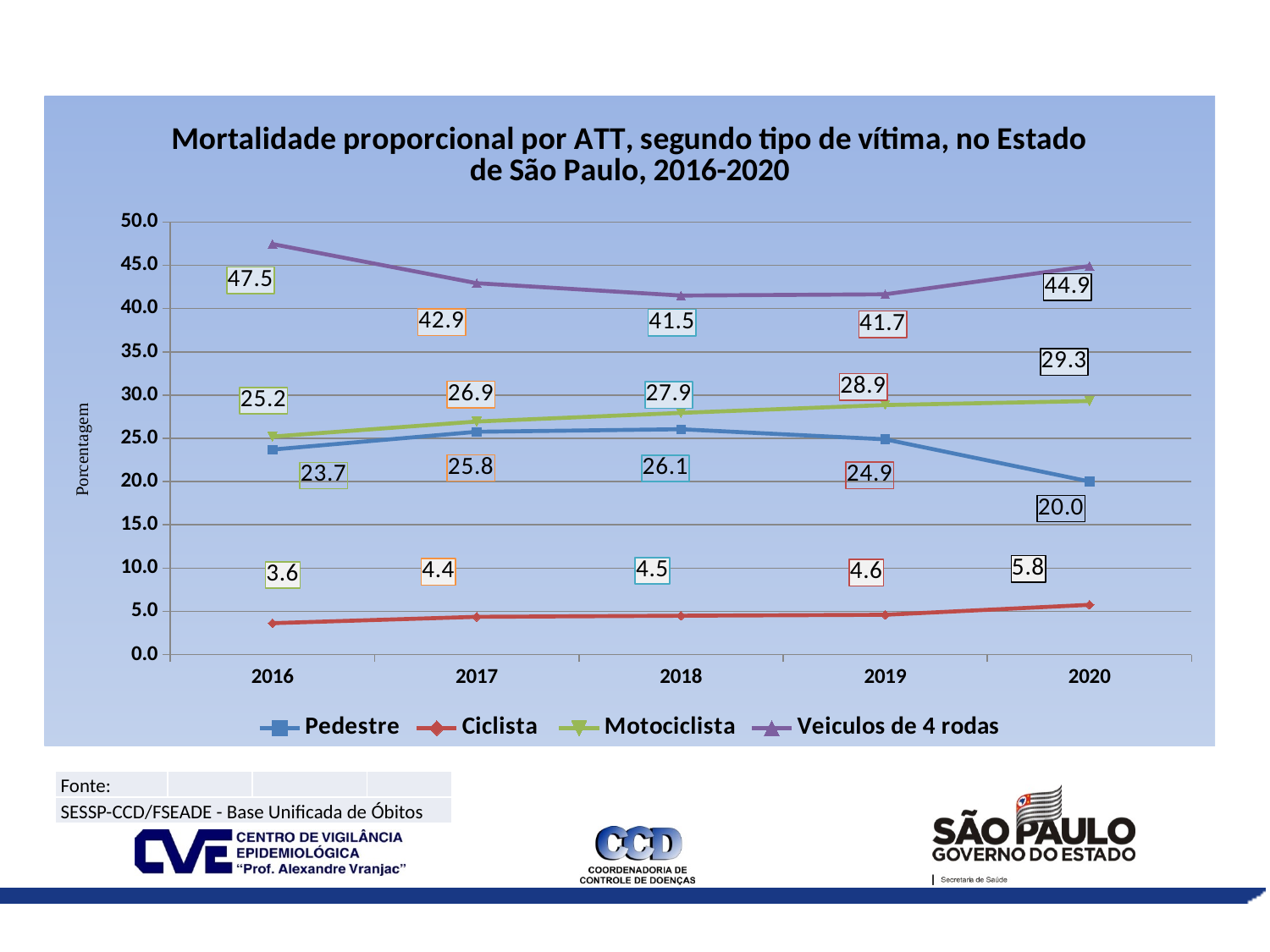
What is the value for Ciclista in 2019? 4.6 What kind of chart is shown on the slide? line chart What is the value for Motociclista in 2018? 27.9 In which year is the Veiculos de 4 rodas value lowest? 2018 Does the Motociclista series rise or fall from 2016 to 2020? rise Which is larger in 2017: the Pedestre value or the Motociclista value? Motociclista How many years are shown on the x axis? 5 How many series does the legend list? 4 In which year is the Pedestre value highest? 2018 What is the difference between the Veiculos de 4 rodas value in 2016 and in 2020? 2.6 What is the value for Veiculos de 4 rodas in 2016? 47.5 What is the value for Pedestre in 2020? 20.0